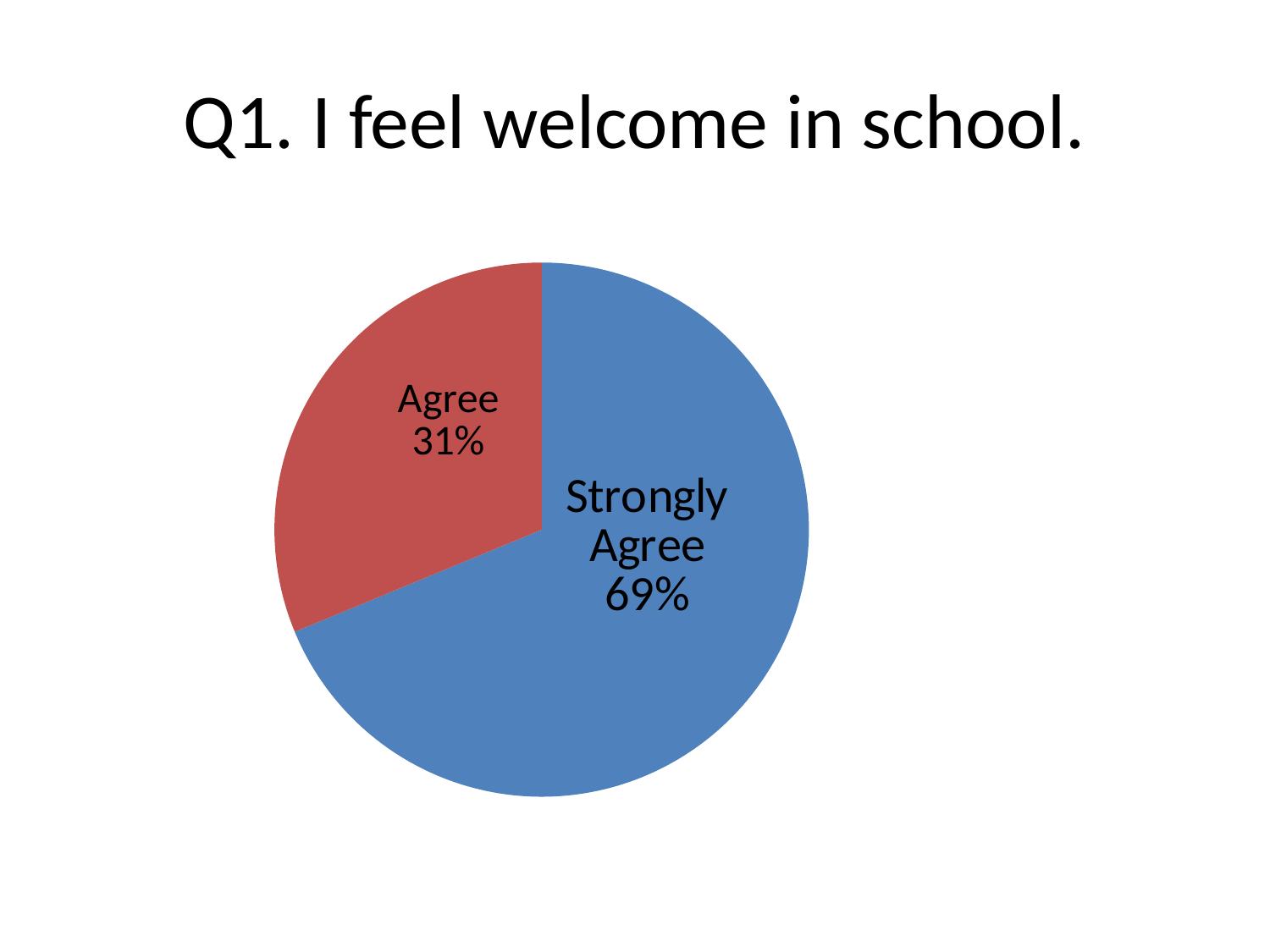
What colour is the Strongly Agree slice? blue Which is larger, the Agree slice or the Strongly Agree slice? Strongly Agree What is the difference in percentage points between the Strongly Agree and Agree slices? 38 How many slices does the pie chart have? 2 What kind of chart is shown on the slide? pie chart What share of the pie is labelled Strongly Agree? 69% What share of the pie is labelled Agree? 31% What is the title of the chart? Q1. I feel welcome in school. Which slice of the pie is the smallest? Agree Which slice of the pie is the largest? Strongly Agree